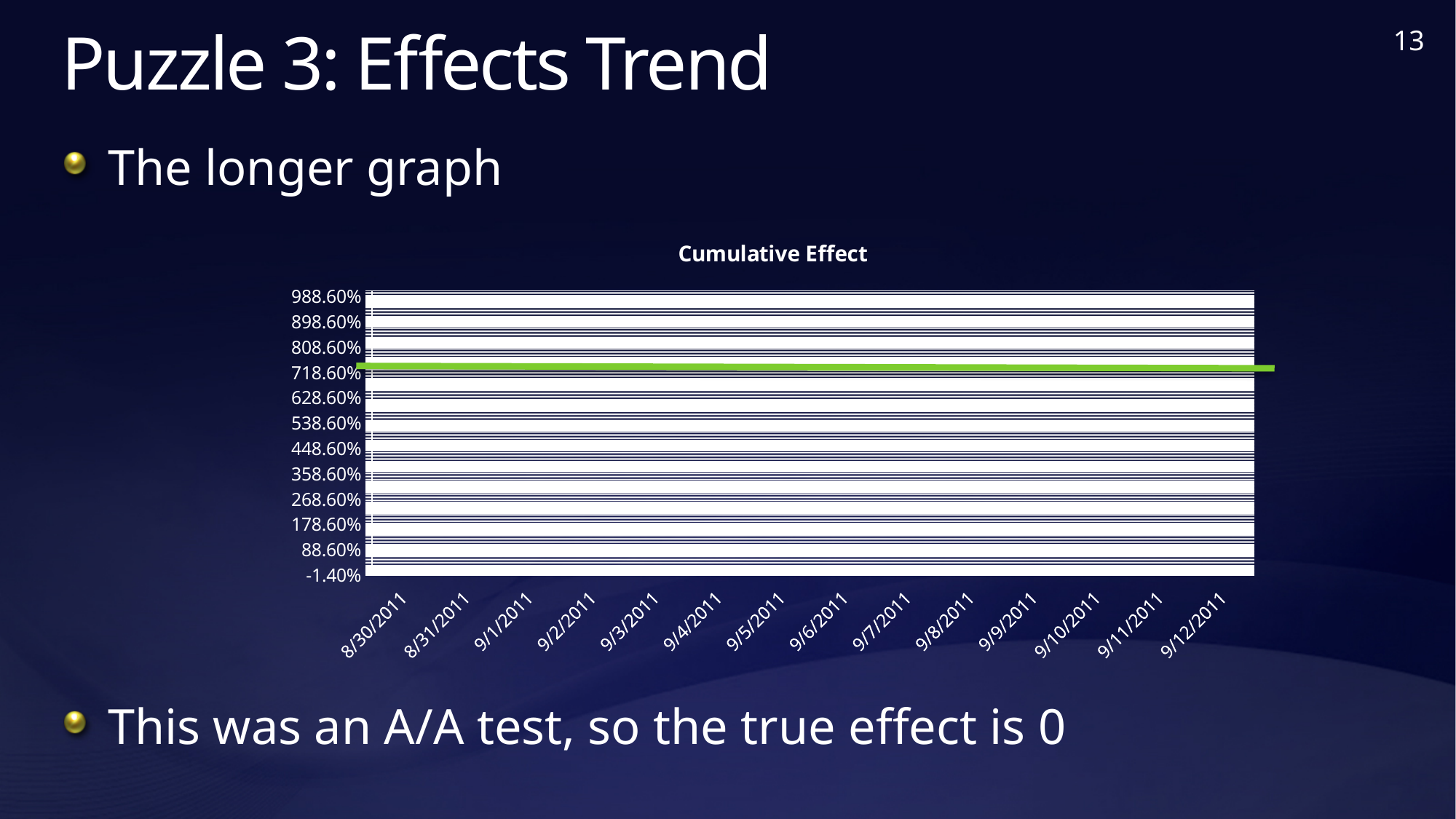
What is the last date shown on the x axis of the chart? 9/12/2011 Is the value for 9/12/2011 greater or less than 808.60%? less Is the value for 8/30/2011 greater or less than 628.60%? greater What is the first date shown on the x axis? 8/30/2011 How many dates are labelled on the x axis of the chart? 14 How many tick labels are shown on the y axis? 12 Is the value for 9/5/2011 greater or less than 448.60%? greater Does the line rise sharply, fall sharply, or stay roughly flat across the dates? Roughly flat What kind of chart is shown on the slide? Line chart What is the title of the chart? Cumulative Effect What is the lowest value labelled on the y axis? -1.40% What is the highest value labelled on the y axis? 988.60%